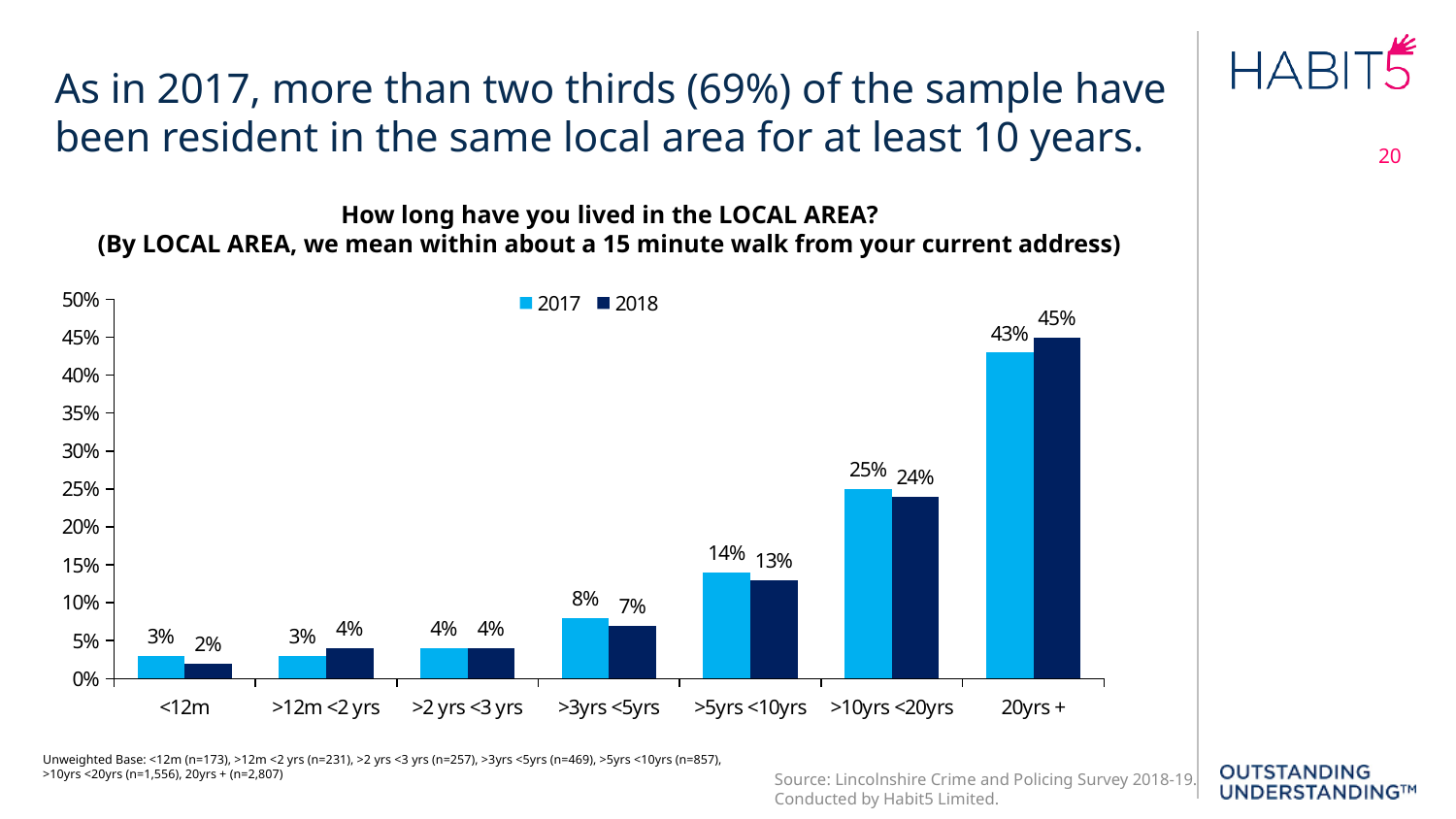
How many categories are shown on the x axis? 7 Which category has the highest 2017 value? 20yrs + Which series is shown in dark navy blue in the legend? 2018 What is the difference between the 2018 and 2017 values for the 20yrs + category? 2% Which is larger for the >10yrs <20yrs category, the 2017 value or the 2018 value? 2017 How many series does the legend list? 2 What is the 2018 value for the 20yrs + category? 45% Is the 2018 value for >10yrs <20yrs greater or less than 20%? greater What is the 2018 value for the <12m category? 2% What kind of chart is shown on the slide? Bar chart Which category has the lowest 2018 value? <12m What is the 2017 value for the >5yrs <10yrs category? 14%